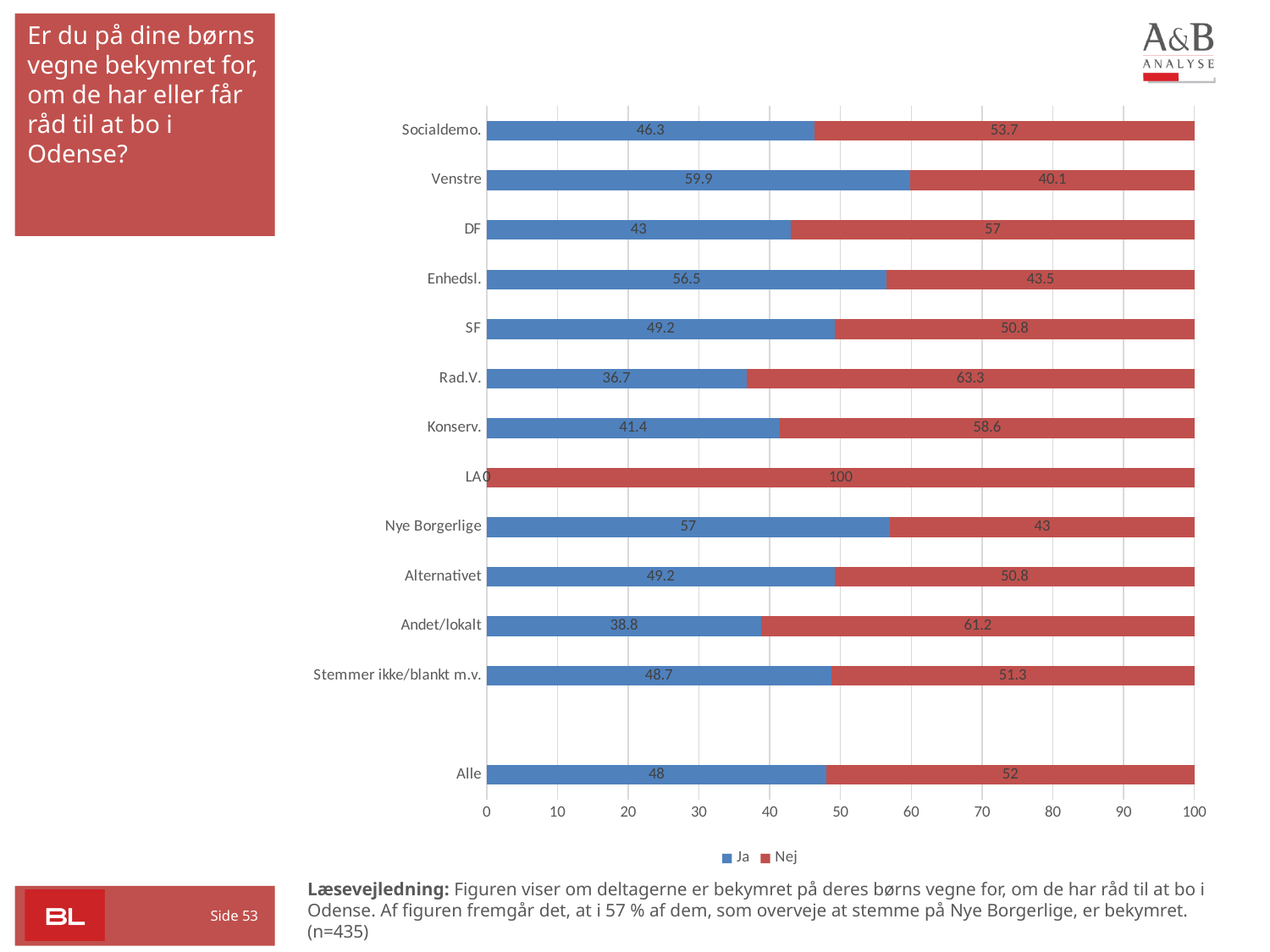
Which is larger, the Ja value for Enhedsl. or the Ja value for Nye Borgerlige? Nye Borgerlige Which category has the lowest Ja value? LA What is the Nej value for Rad.V.? 63.3 What kind of chart is shown on the slide? Stacked bar chart What is the Ja value for Venstre? 59.9 How many series does the legend list? 2 What is the Ja value for Alle? 48 Which category has the highest Ja value? Venstre What is the total of the stacked bar for Socialdemo.? 100 What is the difference between the Nej value and the Ja value for DF? 14 How many categories are shown on the y axis of the chart? 13 What are the two series named in the legend? Ja and Nej